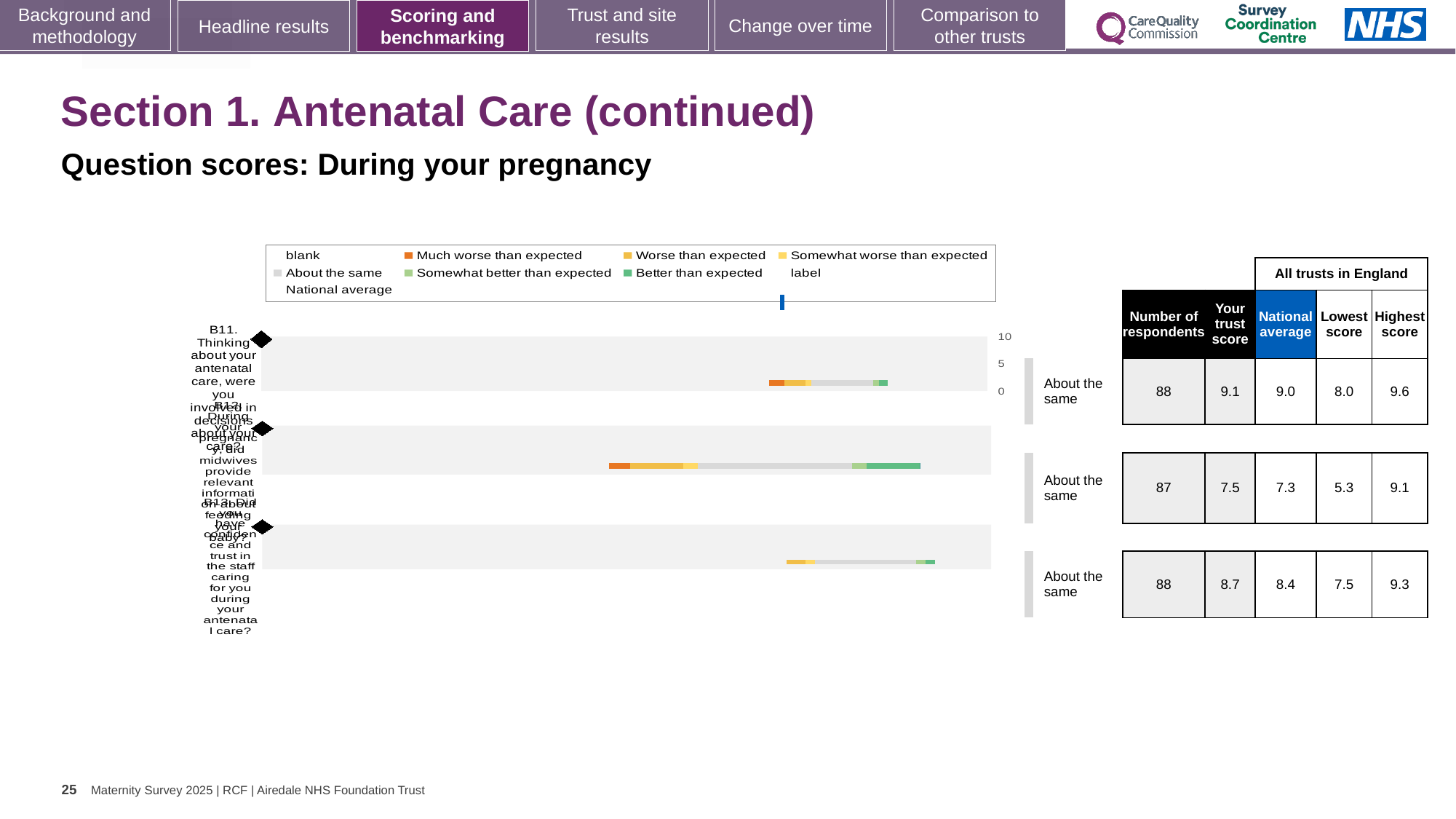
What is the 'Your trust score' value for question B11? 9.1 What is the difference between the highest score and the lowest score for question B11? 1.6 What is the national average for question B12? 7.3 Which question has the lowest 'Lowest score' among all trusts in England? B12 How many respondents answered question B12? 87 How many questions (rows) are plotted in the chart? 3 What is the highest score across all trusts in England for question B13? 9.3 For question B13, which is larger: the trust score or the national average? Your trust score (8.7) What kind of chart is shown on the slide? bar chart What colour does the legend use for 'Much worse than expected'? orange What benchmark category is shown for question B12? About the same Which question has the highest 'Your trust score'? B11